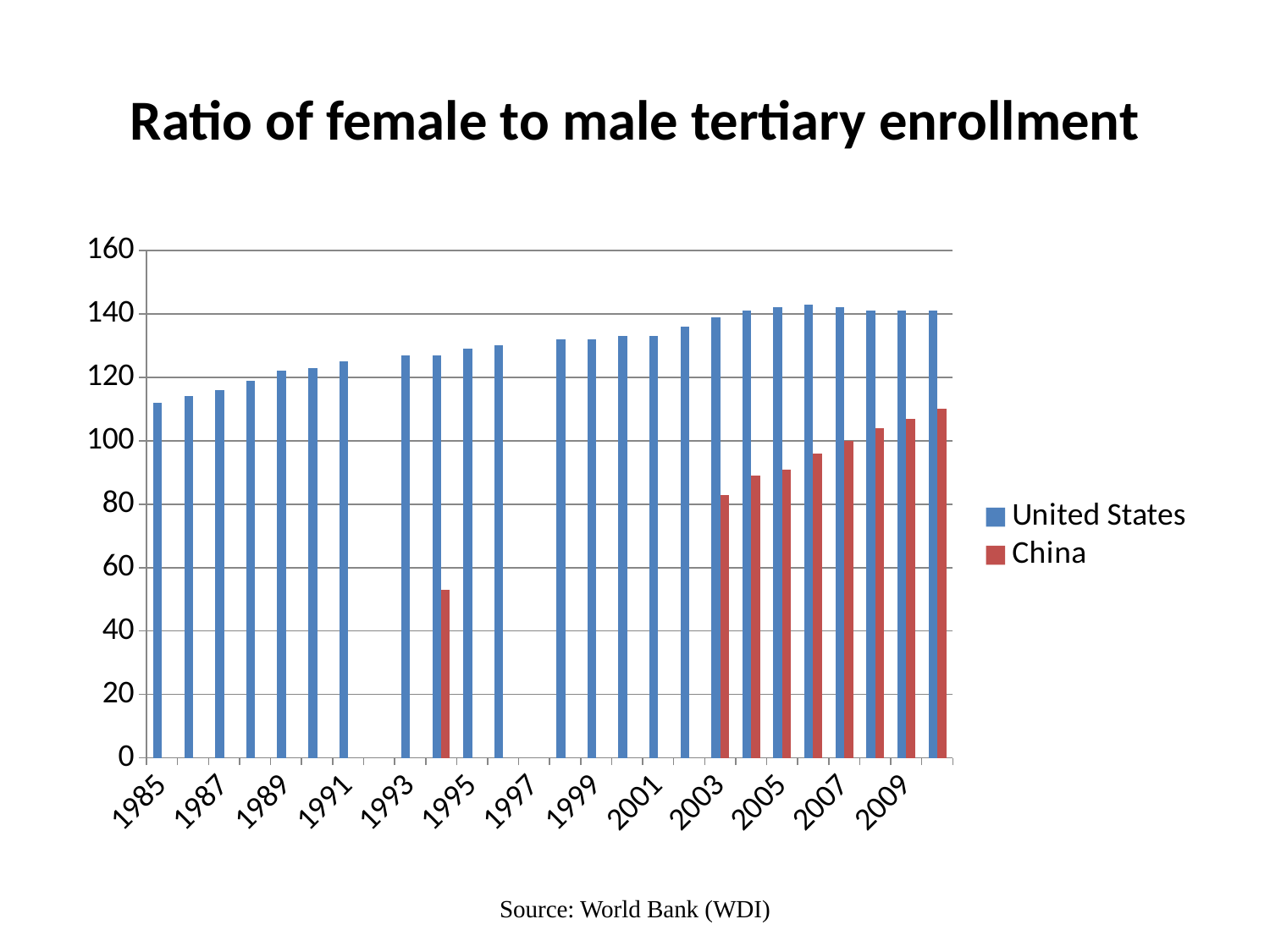
What kind of chart is shown on the slide? bar chart What is the title of the chart? Ratio of female to male tertiary enrollment Is the value for United States in 1985 greater or less than 120? less Is the value for United States in 2005 greater or less than 120? greater In 2005, which series has the larger value, United States or China? United States Is the value for China in 2003 greater or less than 100? less Do the values for China rise or fall from 2003 to 2009? rise Do the values for United States generally rise or fall from 1985 to 2005? rise Which series is shown in red in the chart? China How many series does the legend list? 2